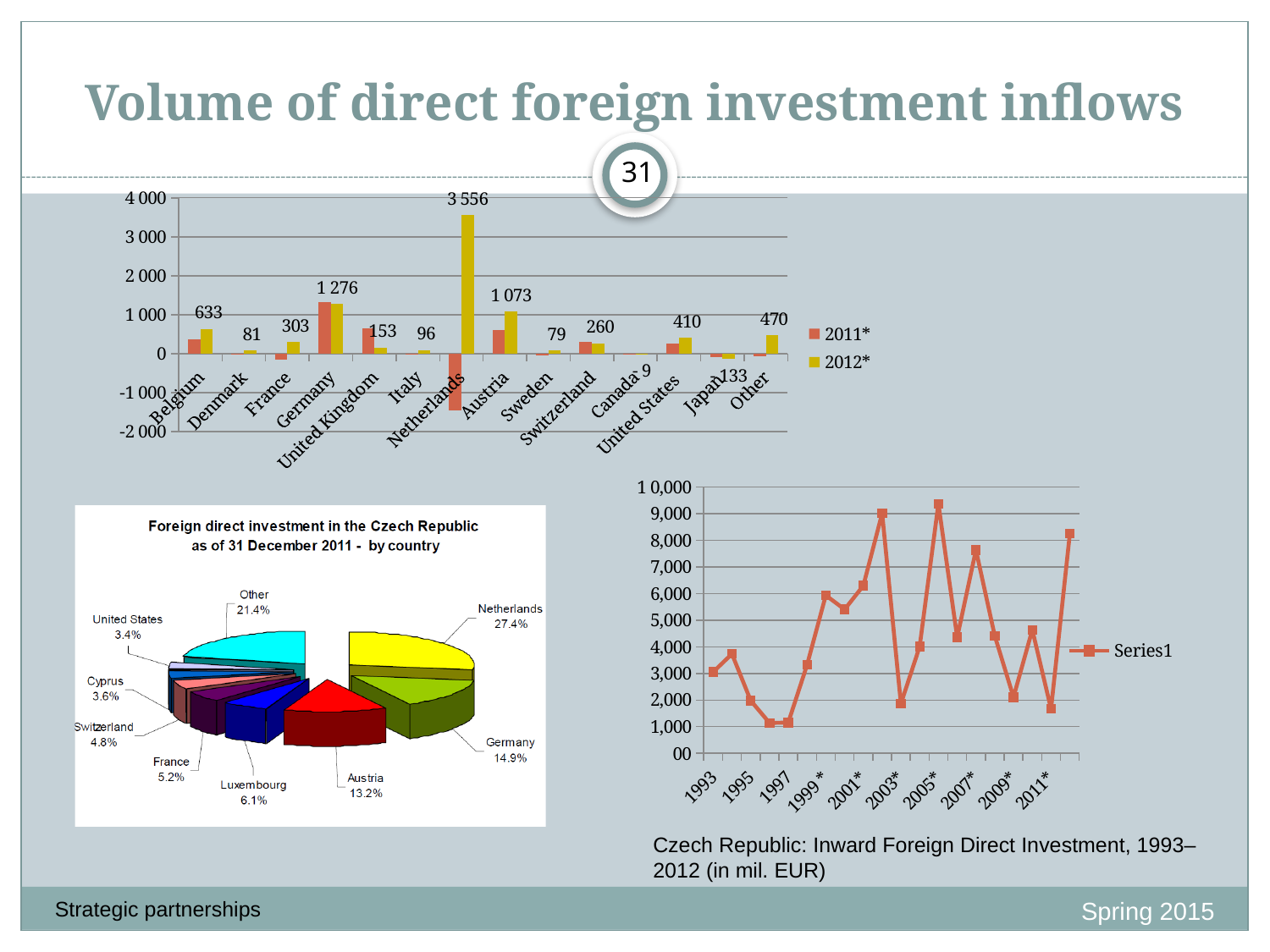
In the pie chart 'Foreign direct investment in the Czech Republic as of 31 December 2011 - by country', which named country has the smallest slice? United States How many slices does the pie chart 'Foreign direct investment in the Czech Republic as of 31 December 2011 - by country' have? 9 How many series does the legend of the top bar chart list? 2 In the top bar chart, what data label is shown for Austria? 1 073 In the top bar chart, what data label is shown for Germany? 1 276 How many countries/categories are shown on the x axis of the top bar chart? 14 In the top bar chart, what data label is shown for Netherlands? 3 556 In the pie chart 'Foreign direct investment in the Czech Republic as of 31 December 2011 - by country', what share does Austria have? 13.2% In the top bar chart, which country has the tallest bar? Netherlands In the line chart 'Czech Republic: Inward Foreign Direct Investment, 1993–2012', is the value for 2003* greater or less than 8,000? less In the pie chart 'Foreign direct investment in the Czech Republic as of 31 December 2011 - by country', what share does Netherlands have? 27.4% In the line chart 'Czech Republic: Inward Foreign Direct Investment, 1993–2012', is the value for 1997 greater or less than 2,000? less